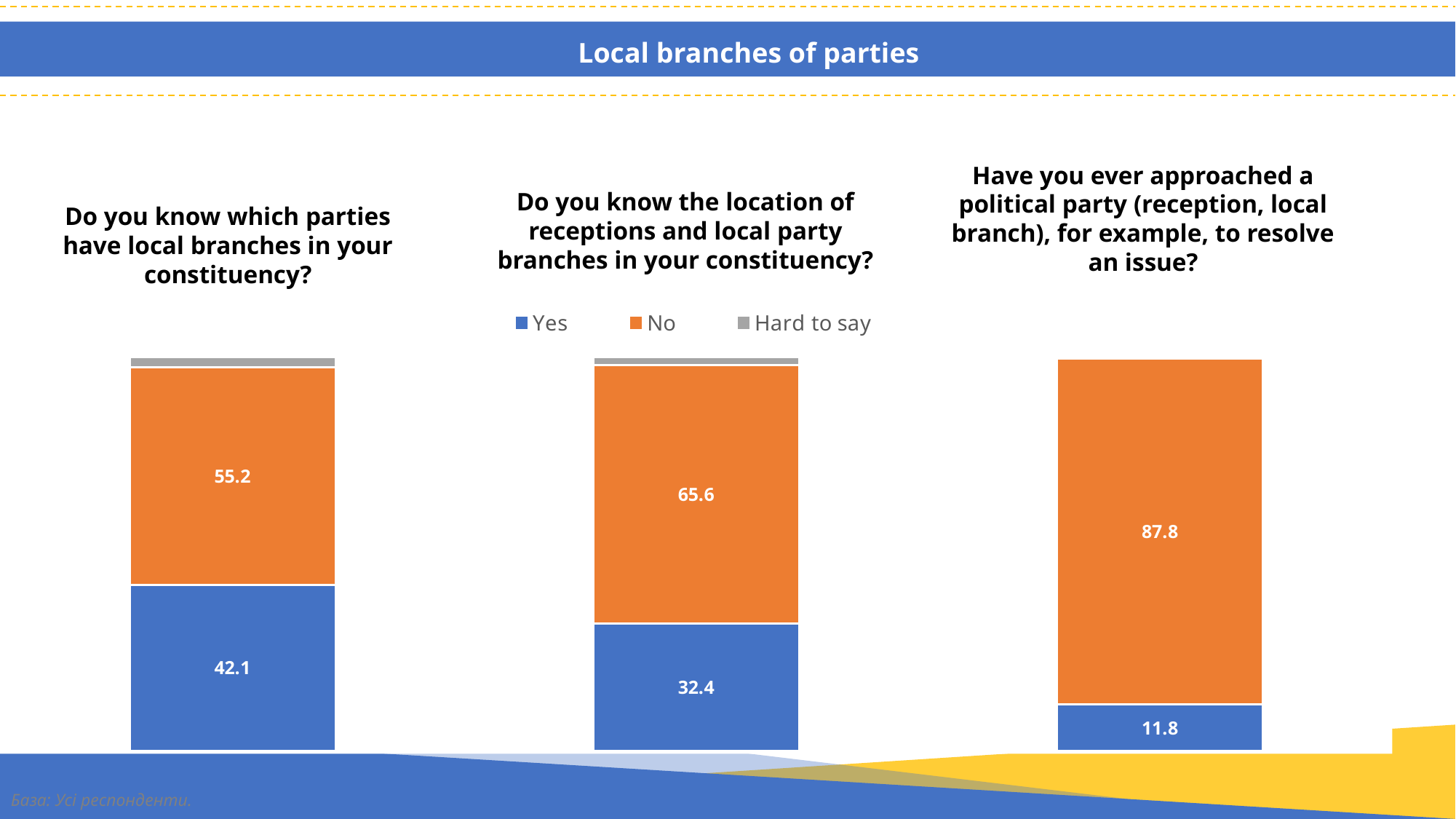
In the chart 'Do you know the location of receptions and local party branches in your constituency?', what is the value for 'Yes'? 32.4 In the chart 'Have you ever approached a political party (reception, local branch), for example, to resolve an issue?', what is the difference between the 'No' and 'Yes' values? 76 In the chart 'Have you ever approached a political party (reception, local branch), for example, to resolve an issue?', what is the value for 'Yes'? 11.8 How many series does the shared legend list? 3 In the chart 'Do you know the location of receptions and local party branches in your constituency?', what is the value for 'No'? 65.6 In the chart 'Do you know the location of receptions and local party branches in your constituency?', which is larger, 'Yes' or 'No'? No In the chart 'Do you know which parties have local branches in your constituency?', what is the difference between the 'No' and 'Yes' values? 13.1 In the chart 'Do you know which parties have local branches in your constituency?', what is the value for 'Yes'? 42.1 Across the three charts, which chart has the highest 'No' value? Have you ever approached a political party (reception, local branch), for example, to resolve an issue? In the chart 'Do you know which parties have local branches in your constituency?', what is the value for 'No'? 55.2 What kind of chart is used for 'Do you know which parties have local branches in your constituency?'? Stacked bar chart In the chart 'Have you ever approached a political party (reception, local branch), for example, to resolve an issue?', what is the value for 'No'? 87.8